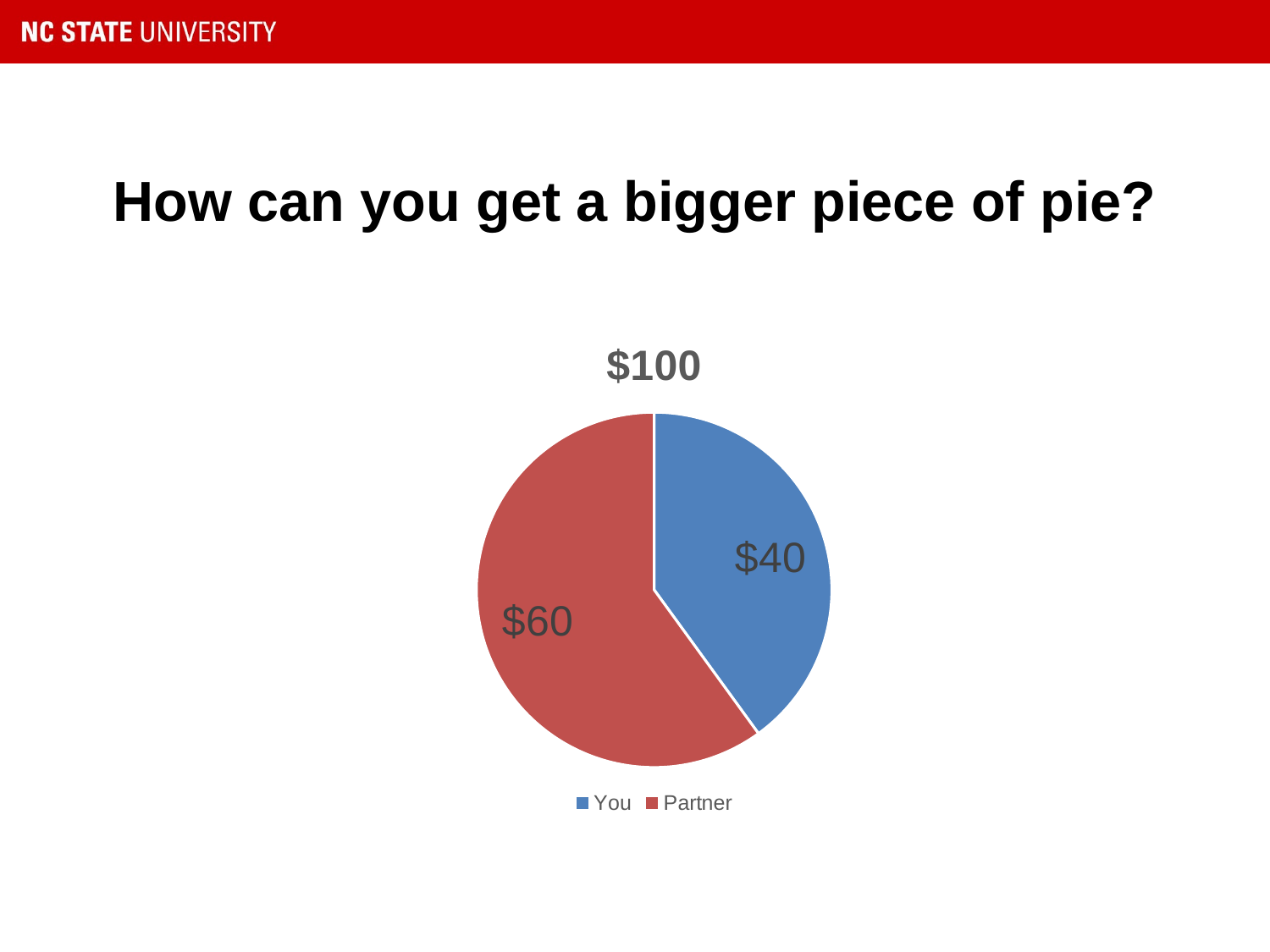
Which category has the largest slice? Partner What share of the pie does the Partner slice represent? 60% What colour is the Partner slice? red What is the title of the chart? $100 Which category has the smallest slice? You What is the difference between the Partner value and the You value? $20 Which is larger, the value for You or the value for Partner? Partner How many slices does the pie chart have? 2 What is the value for You? $40 What is the value for Partner? $60 What kind of chart is shown on the slide? pie chart What share of the pie does the You slice represent? 40%